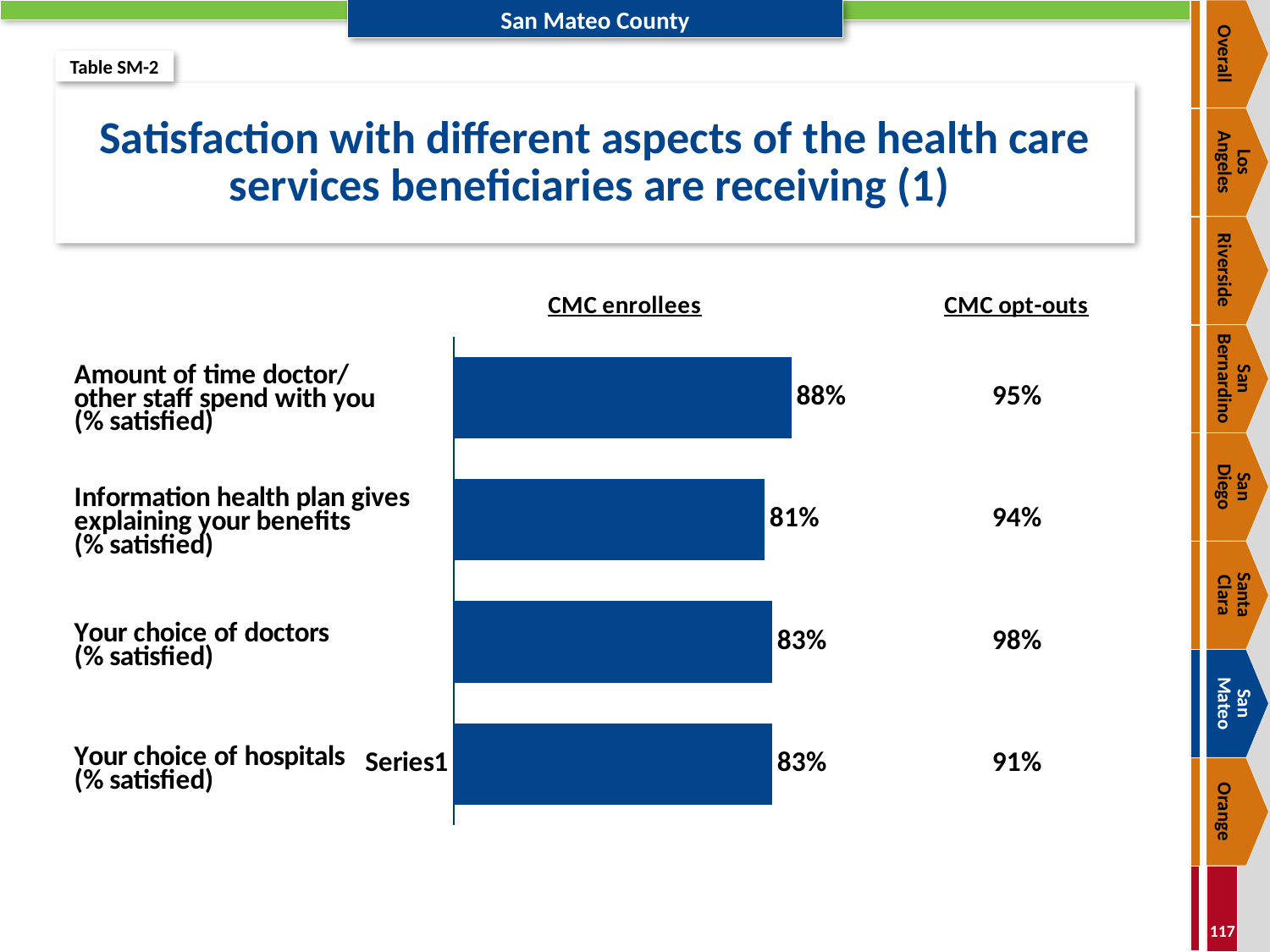
What is the difference in CMC enrollee satisfaction between the amount of time doctor/other staff spend with you and the information the health plan gives explaining your benefits? 7 percentage points What percentage of CMC enrollees are satisfied with their choice of doctors? 83% Which aspect has the highest satisfaction among CMC enrollees? Amount of time doctor/other staff spend with you What type of chart is used to show CMC enrollee satisfaction? Bar chart What is the title of the chart on the slide? Satisfaction with different aspects of the health care services beneficiaries are receiving (1) What percentage of CMC enrollees are satisfied with the amount of time doctor/other staff spend with them? 88% Which aspect has the lowest satisfaction among CMC enrollees? Information health plan gives explaining your benefits What percentage of CMC opt-outs are satisfied with their choice of doctors? 98% What percentage of CMC enrollees are satisfied with their choice of hospitals? 83% What percentage of CMC enrollees are satisfied with the information the health plan gives explaining their benefits? 81% Among CMC enrollees, is satisfaction higher for the amount of time doctor/other staff spend with you or for your choice of doctors? Amount of time doctor/other staff spend with you How many aspects of health care services are shown in the chart? 4